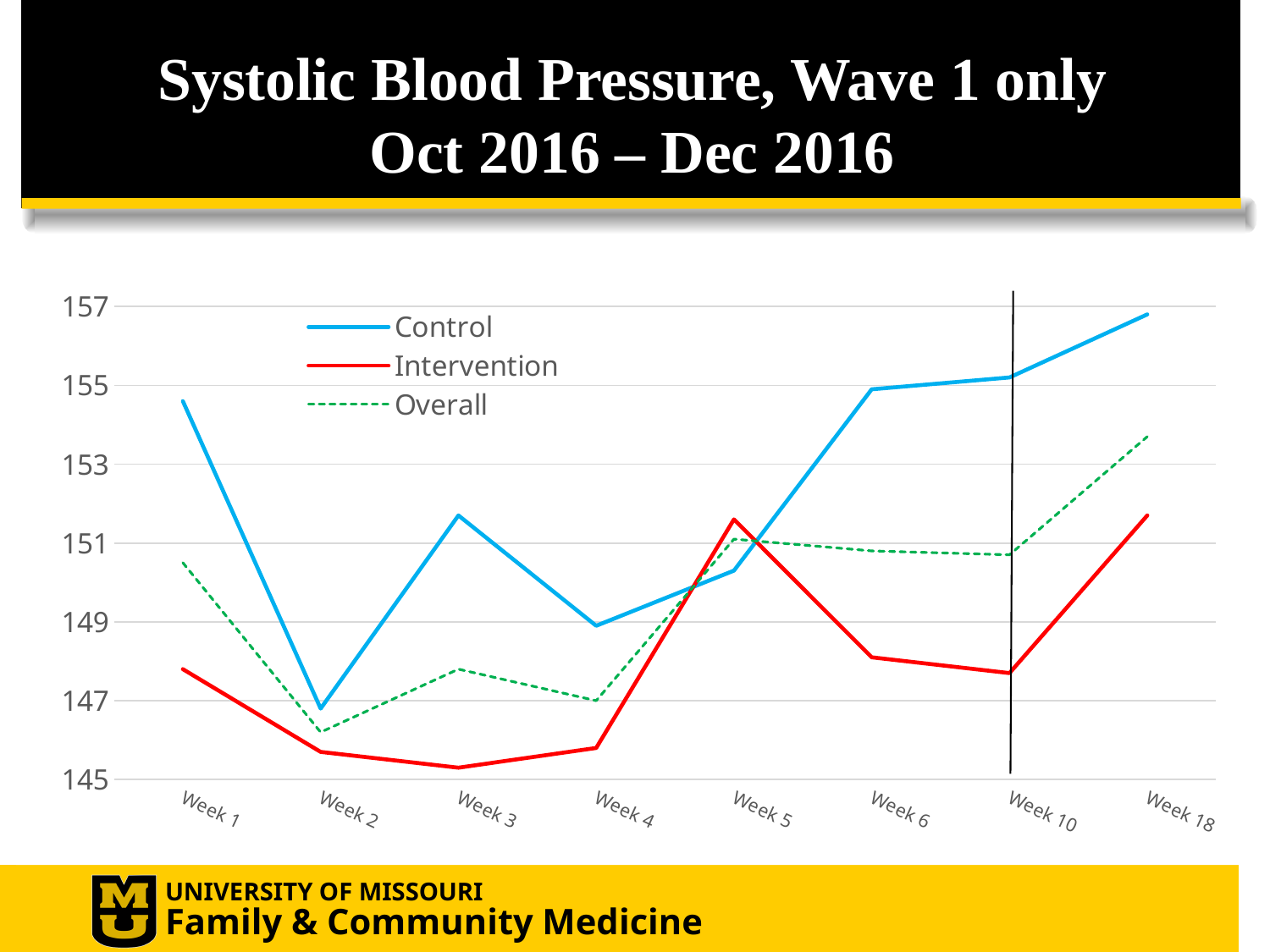
Is the Control value at Week 1 greater or less than 153? greater At which week is the Control series highest? Week 18 At Week 5, which series has the higher value, Control or Intervention? Intervention Which series is drawn with a dashed green line? Overall At which week is the Intervention series lowest? Week 3 Is the Overall value at Week 18 greater or less than 153? greater Is the Intervention value at Week 5 greater or less than 151? greater Does the Control series rise or fall from Week 6 to Week 18? Rises How many week categories are shown on the x axis? 8 At which week is the Control series lowest? Week 2 How many series does the legend list? 3 What kind of chart is shown on the slide? Line chart